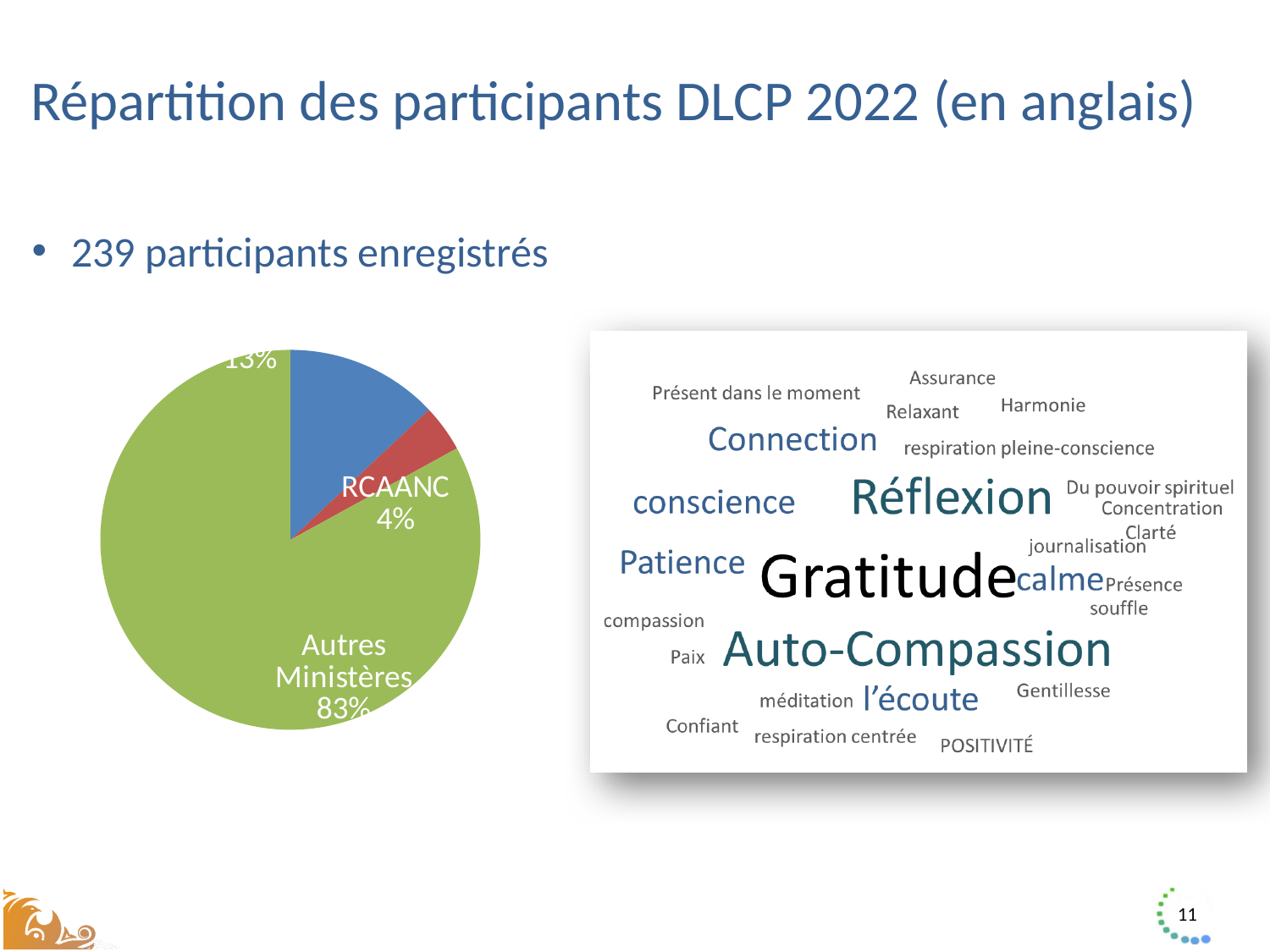
What share of the pie does RCAANC represent? 4% Which slice of the pie chart is the smallest? RCAANC What colour is the Autres Ministères slice in the pie chart? green What is the difference in percentage points between Autres Ministères and RCAANC in the pie chart? 79% Which is larger in the pie chart, Autres Ministères or RCAANC? Autres Ministères What percentage of the pie chart is labelled RCAANC? 4% How many slices does the pie chart have? 3 Which labelled slice of the pie chart is the largest? Autres Ministères What colour is the RCAANC slice in the pie chart? red What kind of chart is shown on the slide? pie chart What percentage of the pie chart is labelled Autres Ministères? 83%